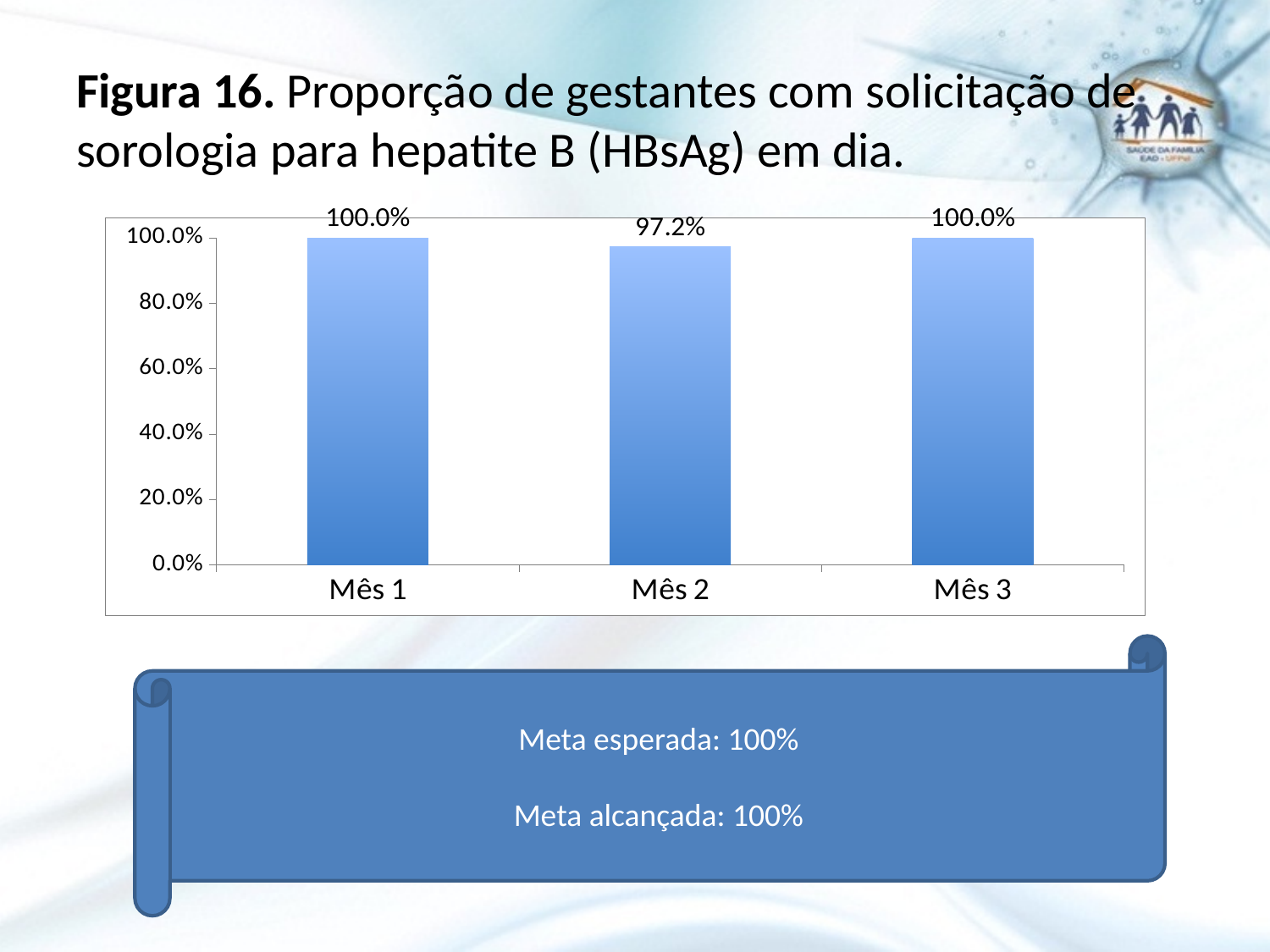
Which is larger, the value for Mês 2 or the value for Mês 3? Mês 3 What is the highest value shown on the y axis? 100.0% What is the value for Mês 2? 97.2% What kind of chart is shown on the slide? bar chart How many categories are shown on the x axis? 3 What is the difference between the values for Mês 1 and Mês 2? 2.8% What is the figure number given in the slide title? Figura 16 Which month has the lowest value? Mês 2 What is the value for Mês 1? 100.0% Is the value for Mês 2 greater or less than 80.0%? greater Does the value fall or rise from Mês 2 to Mês 3? rise What is the value for Mês 3? 100.0%